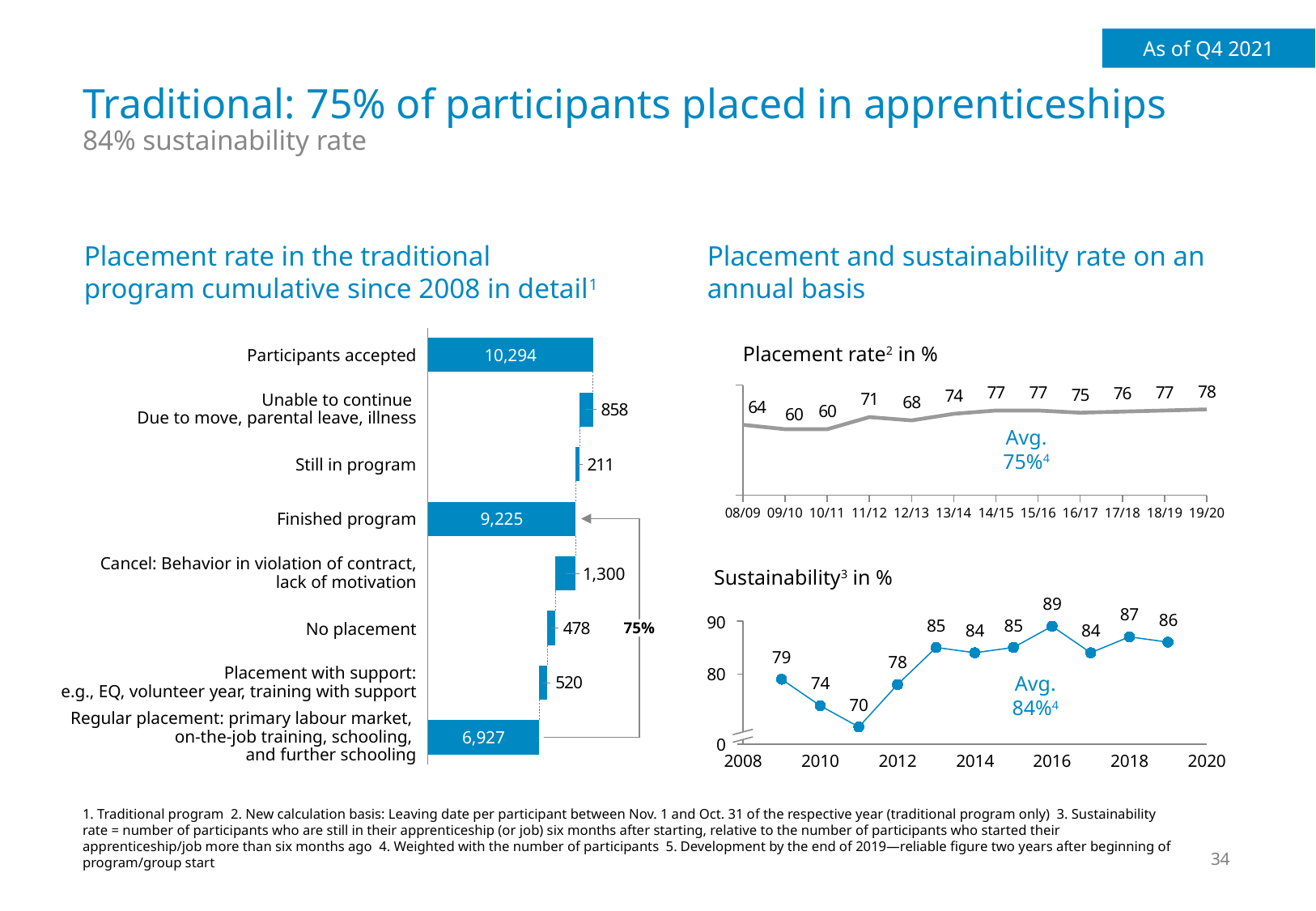
What kind of chart is the 'Placement rate in the traditional program cumulative since 2008 in detail' chart? Bar chart In the 'Placement rate in the traditional program cumulative since 2008 in detail' chart, what is the value for Participants accepted? 10,294 How many categories are shown in the 'Placement rate in the traditional program cumulative since 2008 in detail' chart? 8 In the 'Placement rate in the traditional program cumulative since 2008 in detail' chart, what is the difference between Participants accepted and Finished program? 1,069 In the 'Placement rate in the traditional program cumulative since 2008 in detail' chart, what is the value for Regular placement? 6,927 How many data points are plotted in the 'Placement rate in %' chart? 12 In the 'Placement rate in %' chart, what is the value for 19/20? 78 In the 'Sustainability in %' chart, which year has the highest value? 2016 In the 'Placement rate in %' chart, which period has the lowest value? 09/10 and 10/11 (60) In the 'Placement rate in the traditional program cumulative since 2008 in detail' chart, what is the value for Finished program? 9,225 In the 'Sustainability in %' chart, what is the difference between 2016 and 2011? 19 In the 'Placement rate in the traditional program cumulative since 2008 in detail' chart, which is larger: Cancel (behavior in violation of contract) or Unable to continue? Cancel: Behavior in violation of contract, lack of motivation